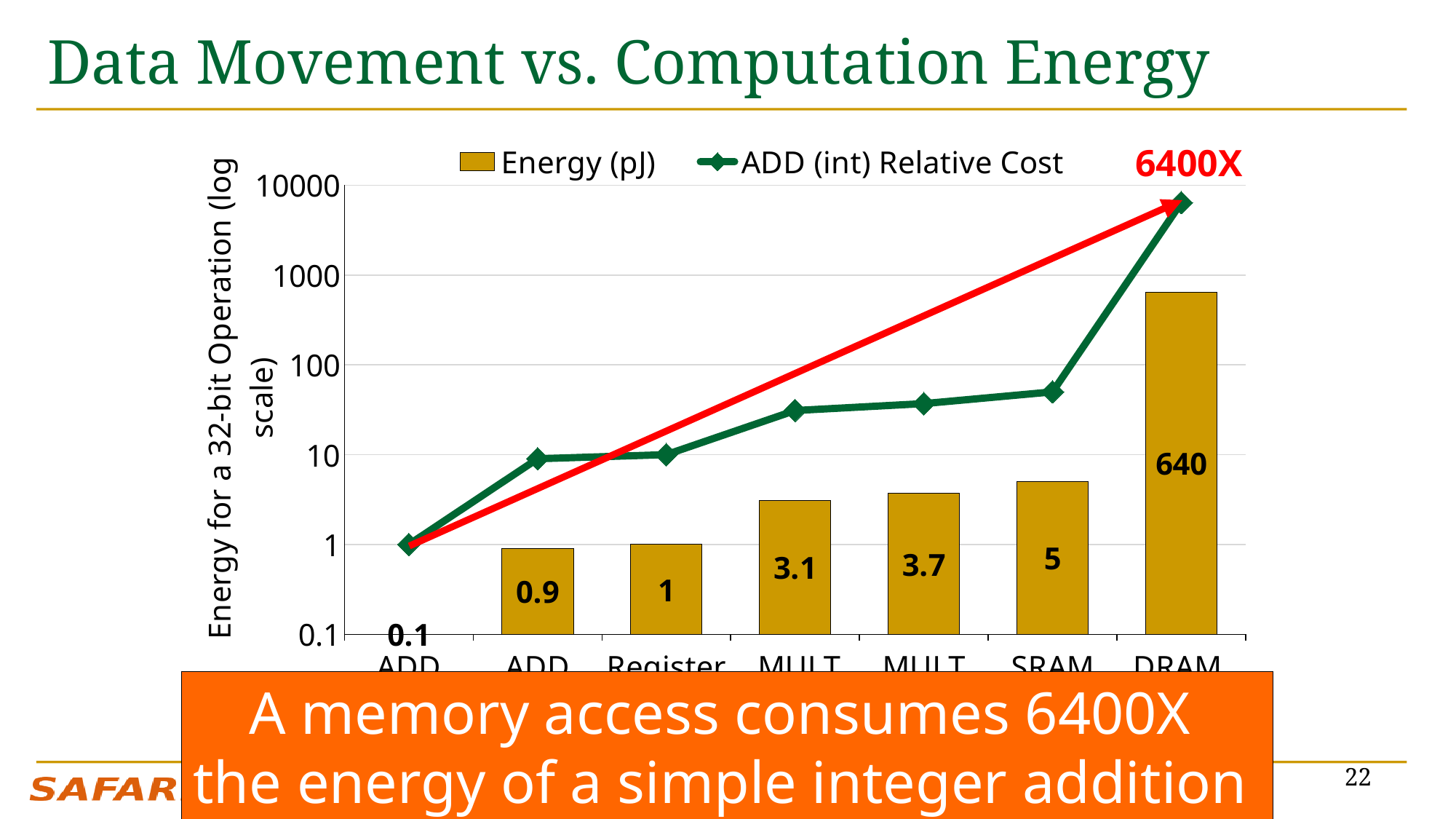
Is the ADD (int) Relative Cost value for DRAM greater or less than 1000? greater Which category has the lowest Energy (pJ) value? The leftmost ADD (0.1) What is the Energy (pJ) value shown for DRAM? 640 What is the difference between the Energy (pJ) values for DRAM and SRAM? 635 What kind of chart is this? A combined bar and line chart How many categories are shown on the x axis? 7 Which category has the highest Energy (pJ) bar? DRAM Do the Energy (pJ) bars rise or fall from left to right along the x axis? rise How many series does the legend list? 2 What is the Energy (pJ) value shown for SRAM? 5 Which has a larger Energy (pJ) value, SRAM or Register? SRAM What is the Energy (pJ) value shown for Register? 1